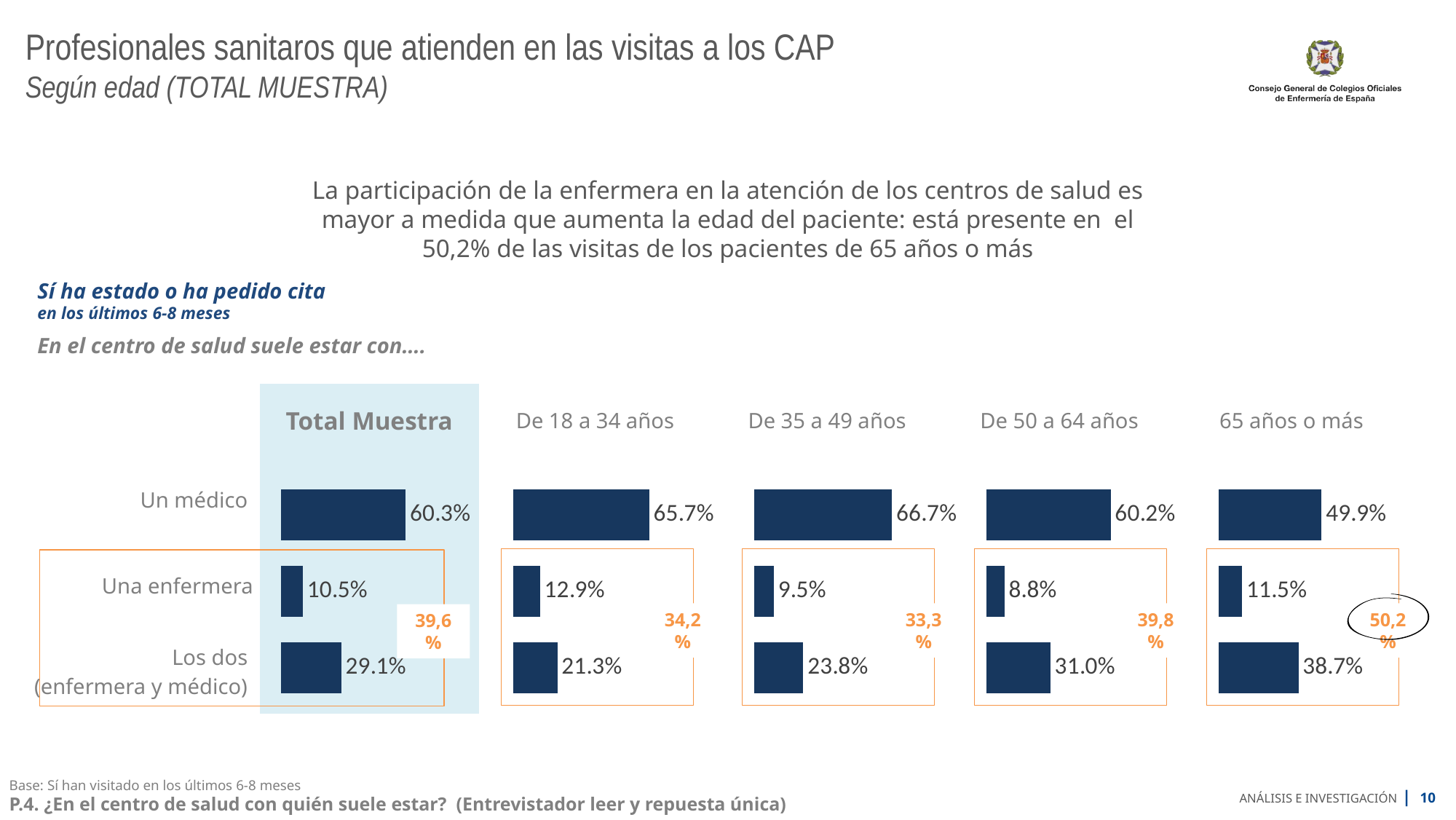
In the '65 años o más' chart, what is the value for 'Los dos (enfermera y médico)'? 38.7% Which chart on the slide is highlighted with a light blue background? Total Muestra How many categories does each of the bar charts on the slide show? 3 In the 'Total Muestra' chart, what is the value for 'Un médico'? 60.3% In the 'De 35 a 49 años' chart, what is the total of 'Una enfermera' and 'Los dos (enfermera y médico)'? 33.3% In the 'Total Muestra' chart, which is larger: 'Una enfermera' or 'Los dos (enfermera y médico)'? Los dos (enfermera y médico) In the 'De 35 a 49 años' chart, which category has the lowest value? Una enfermera How many separate bar charts are shown on the slide? 5 In the '65 años o más' chart, what is the difference between 'Un médico' and 'Los dos (enfermera y médico)'? 11.2% In the 'De 50 a 64 años' chart, what is the value for 'Una enfermera'? 8.8% What kind of chart is the 'De 50 a 64 años' chart? Bar chart In the 'De 18 a 34 años' chart, which category has the highest value? Un médico